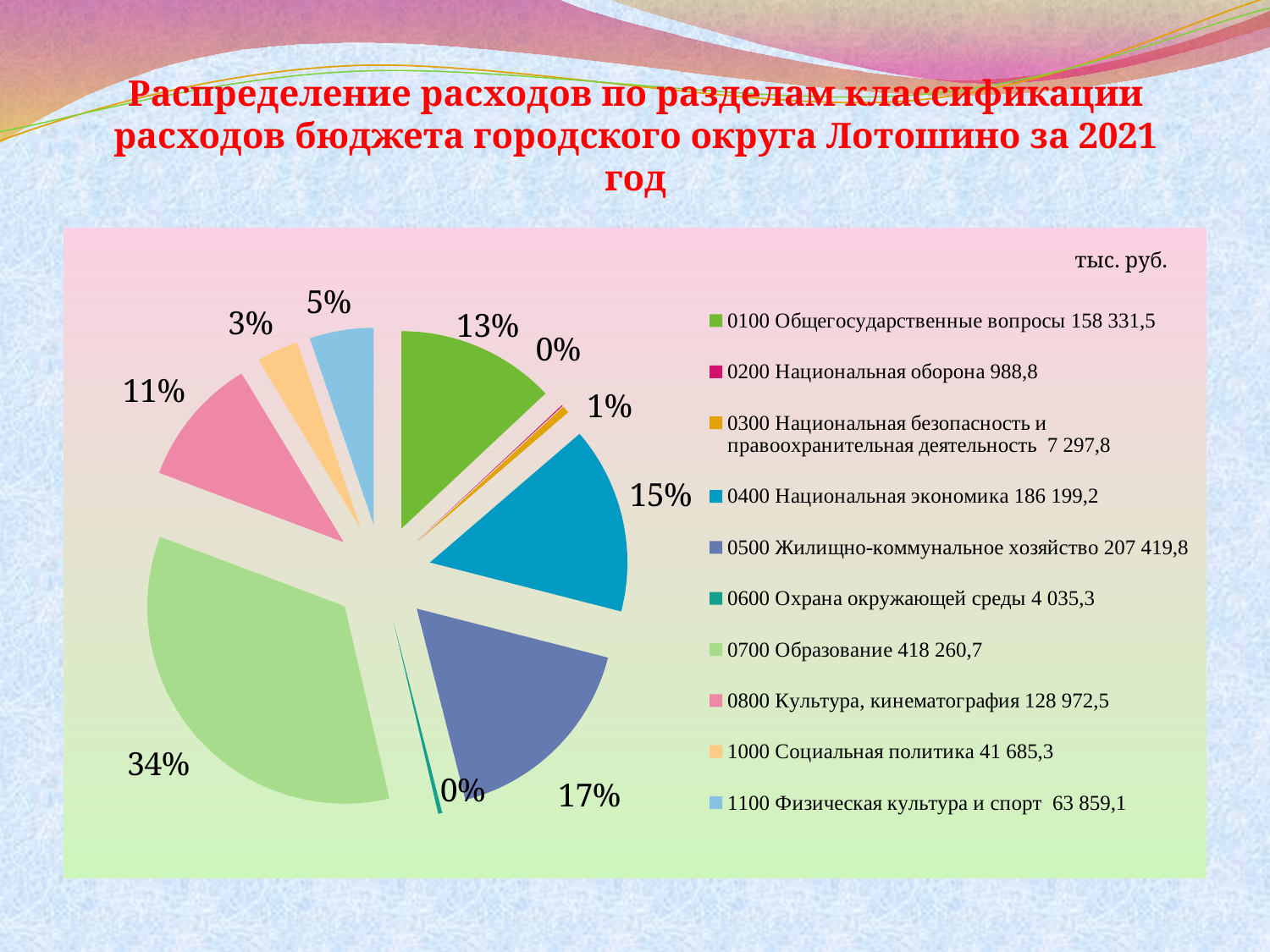
In what units are the legend values given, according to the label in the top right of the chart? тыс. руб. What share of the pie does 0500 Жилищно-коммунальное хозяйство take? 17% Which is larger: 0400 Национальная экономика or 0500 Жилищно-коммунальное хозяйство? 0500 Жилищно-коммунальное хозяйство Which category has the smallest value in the legend? 0200 Национальная оборона What kind of chart is shown on the slide? pie chart What value is given in the legend for 0800 Культура, кинематография? 128 972,5 How many categories (slices) does the pie chart have? 10 What is the difference in percentage points between the shares of 0700 Образование and 0500 Жилищно-коммунальное хозяйство? 17% What share of the pie does 0700 Образование take? 34% What share of the pie does 0400 Национальная экономика take? 15% Which category has the largest share of expenditures? 0700 Образование What value is given in the legend for 0100 Общегосударственные вопросы? 158 331,5